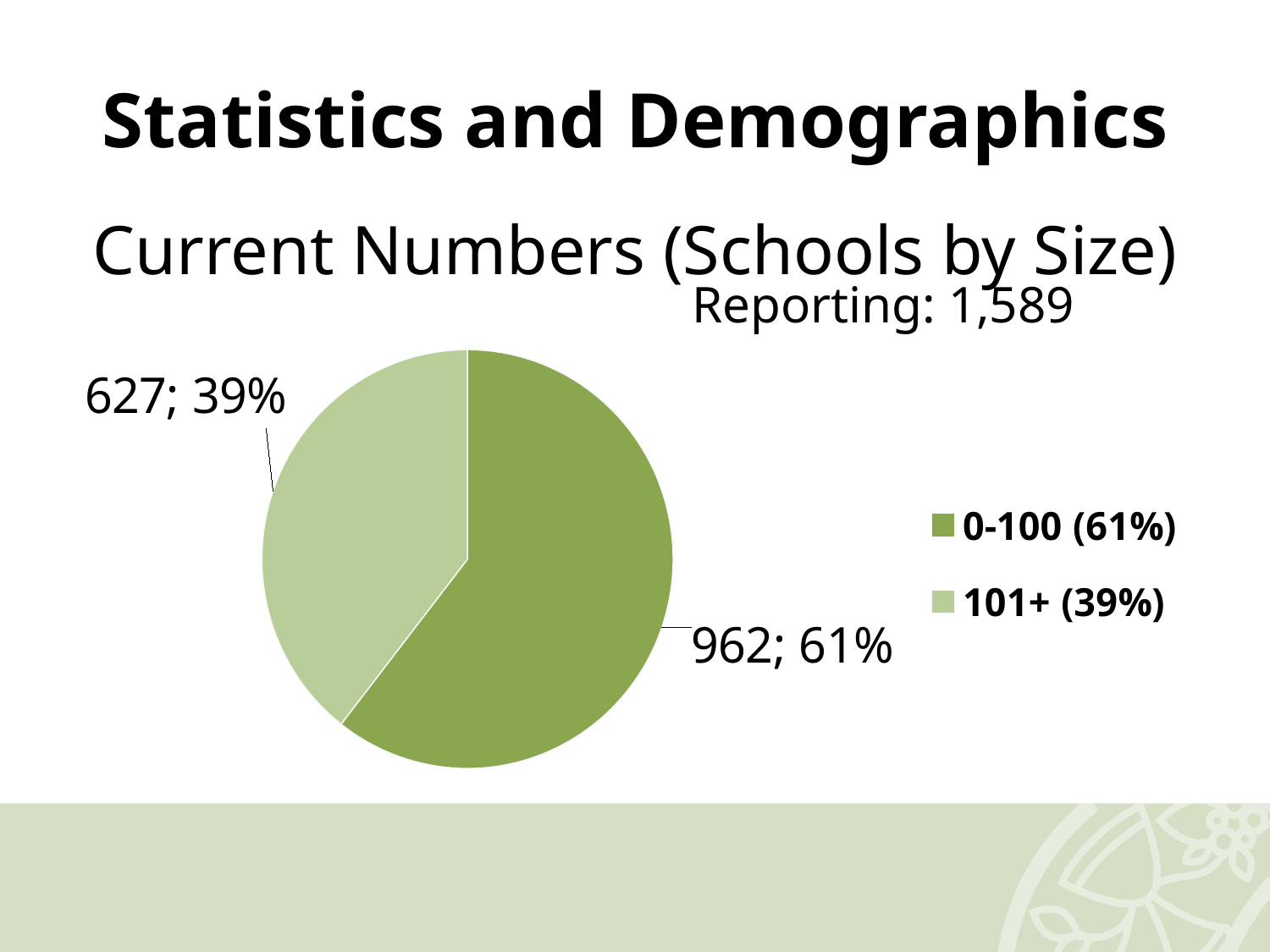
What kind of chart is shown on the slide? pie chart Which category has the largest slice of the pie? 0-100 Which category has more schools, 0-100 or 101+? 0-100 What share of the pie does the 0-100 category represent? 61% How many schools are in the 101+ size category? 627 Which category has the smallest slice of the pie? 101+ How many categories does the pie chart show? 2 What share of the pie does the 101+ category represent? 39% What is the difference in the number of schools between the 0-100 and 101+ categories? 335 What is the title of the chart? Current Numbers (Schools by Size) What is the total number of schools reporting, as stated on the slide? 1,589 How many schools are in the 0-100 size category? 962